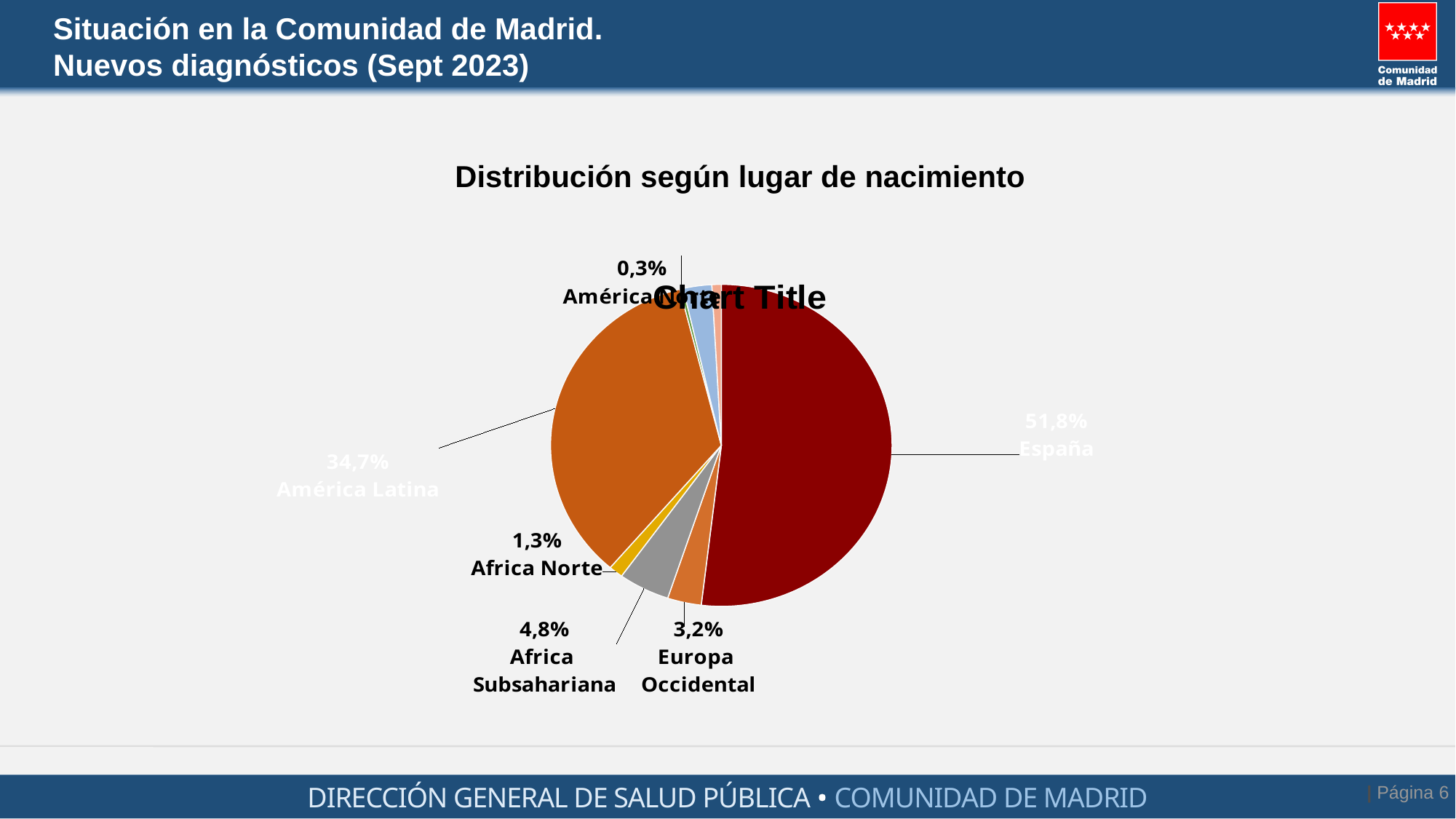
What percentage is shown for Africa Norte? 1,3% What is the difference in percentage points between Africa Subsahariana and Europa Occidental? 1,6 What share of the pie does España represent? 51,8% What percentage is shown for América Latina? 34,7% What percentage is shown for Africa Subsahariana? 4,8% What is the title shown above the chart? Distribución según lugar de nacimiento What is the difference in percentage points between España and América Latina? 17,1 Which is larger, the share for Africa Norte or the share for Europa Occidental? Europa Occidental Which is larger, the share for Africa Subsahariana or the share for Europa Occidental? Africa Subsahariana What kind of chart is shown on the slide? Pie chart What percentage is shown for Europa Occidental? 3,2% Which place of birth has the largest share of the pie? España